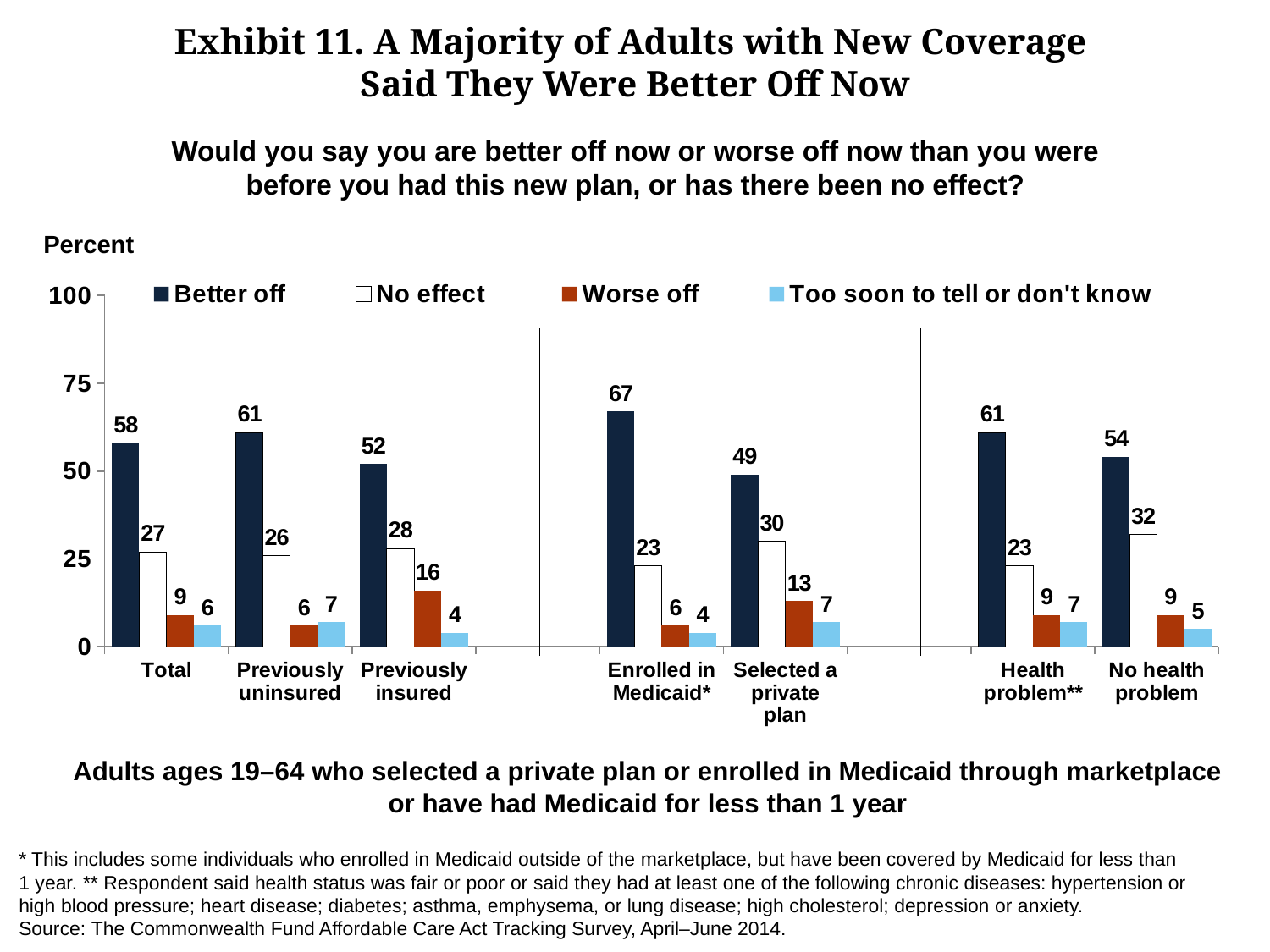
Which is larger, the 'No effect' value for Enrolled in Medicaid* or for Selected a private plan? Selected a private plan What kind of chart is shown on the slide? Bar chart Which category has the lowest 'Better off' value? Selected a private plan What is the 'Too soon to tell or don't know' value for the No health problem group? 5 Which category has the highest 'Better off' value? Enrolled in Medicaid* What is the 'No effect' value for the Previously insured group? 28 What is the 'Worse off' value for those who selected a private plan? 13 What percent of adults in the Total group said they were better off? 58 How many categories are shown on the x axis? 7 Is the 'Better off' value for Previously uninsured greater or less than 50? greater How many series does the legend list? 4 What is the difference between the 'Better off' values for Health problem** and No health problem? 7